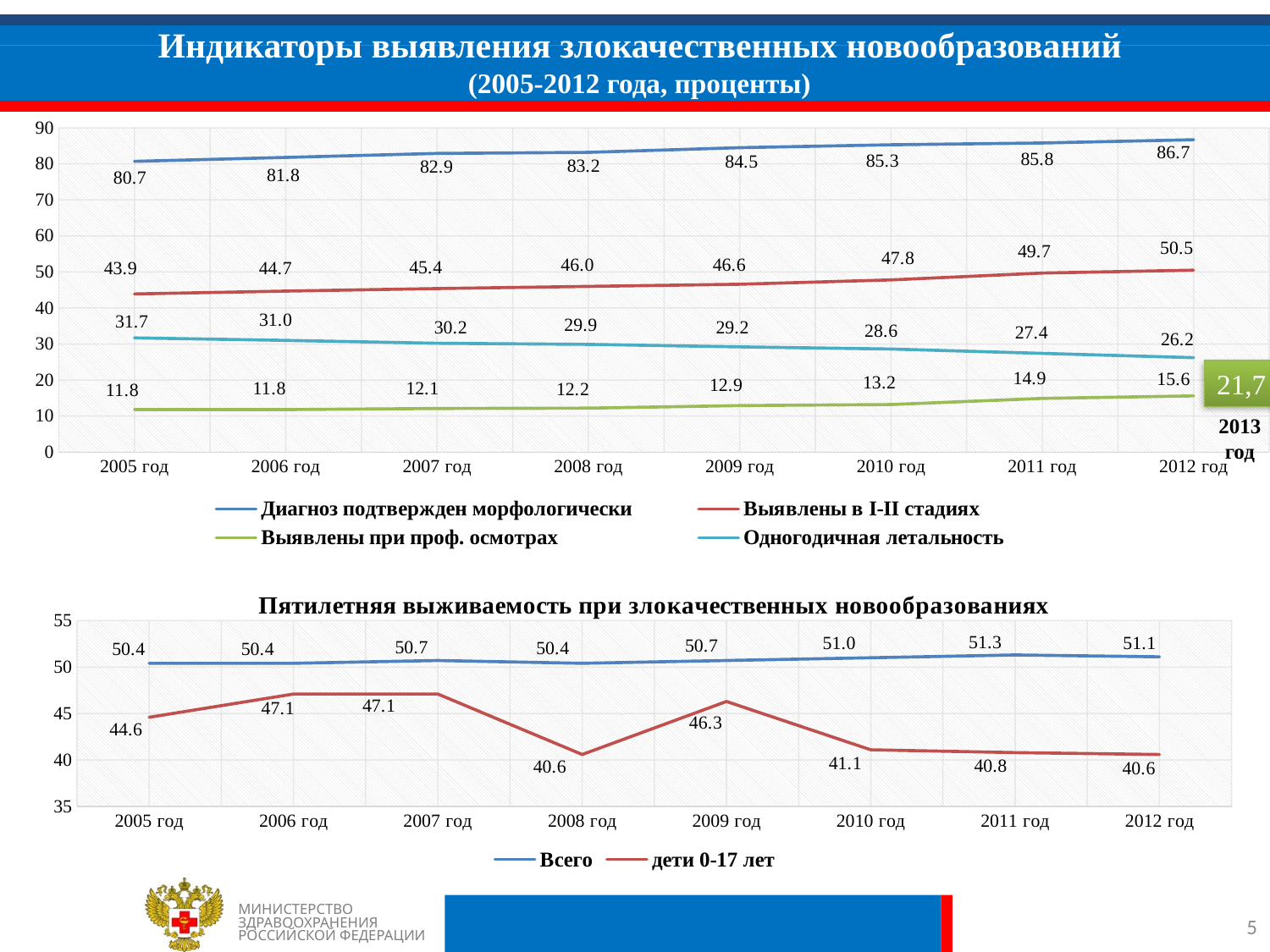
In the bottom chart, which is larger in 2007 год: 'Всего' or 'дети 0-17 лет'? Всего In the top chart, what is the difference between 'Диагноз подтвержден морфологически' in 2012 год and in 2005 год? 6.0 In the top chart, what is the value of 'Выявлены в I-II стадиях' for 2008 год? 46.0 In the top chart (Индикаторы выявления злокачественных новообразований), what is the value of 'Диагноз подтвержден морфологически' for 2012 год? 86.7 In the bottom chart, what is the value of 'дети 0-17 лет' for 2009 год? 46.3 What type of chart is the bottom chart (Пятилетняя выживаемость при злокачественных новообразованиях)? line chart In the top chart, what is the value of 'Одногодичная летальность' for 2005 год? 31.7 In the top chart, in which year is 'Выявлены при проф. осмотрах' highest? 2012 год In the bottom chart, in which year is 'Всего' highest? 2011 год How many years are shown on the x axis of the bottom chart? 8 How many series does the legend of the top chart list? 4 In the top chart, does 'Одногодичная летальность' rise or fall from 2005 год to 2012 год? fall